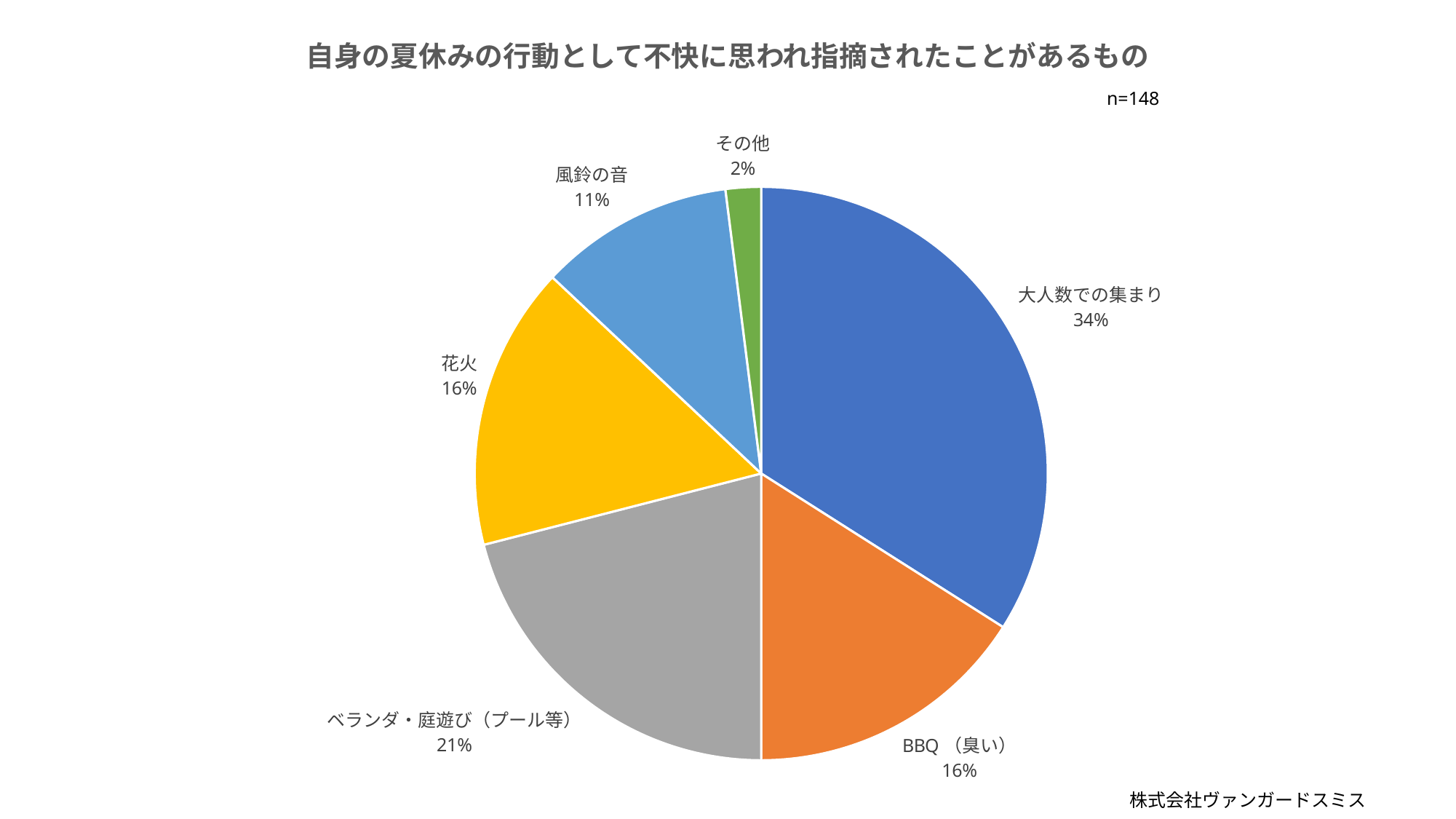
How many categories are shown in the pie chart? 6 Which is larger, the share for 花火 or the share for 風鈴の音? 花火 What is the value shown for 風鈴の音? 11% What is the sample size (n) shown on the slide? n=148 Which category has the smallest slice of the pie? その他 What kind of chart is shown on the slide? pie chart What is the value shown for BBQ（臭い）? 16% What is the value shown for ベランダ・庭遊び（プール等）? 21% What is the difference between the shares of 大人数での集まり and ベランダ・庭遊び（プール等）? 13 percentage points Which category has the largest slice of the pie? 大人数での集まり What colour is the slice for 花火? yellow What share of the pie does 大人数での集まり have? 34%